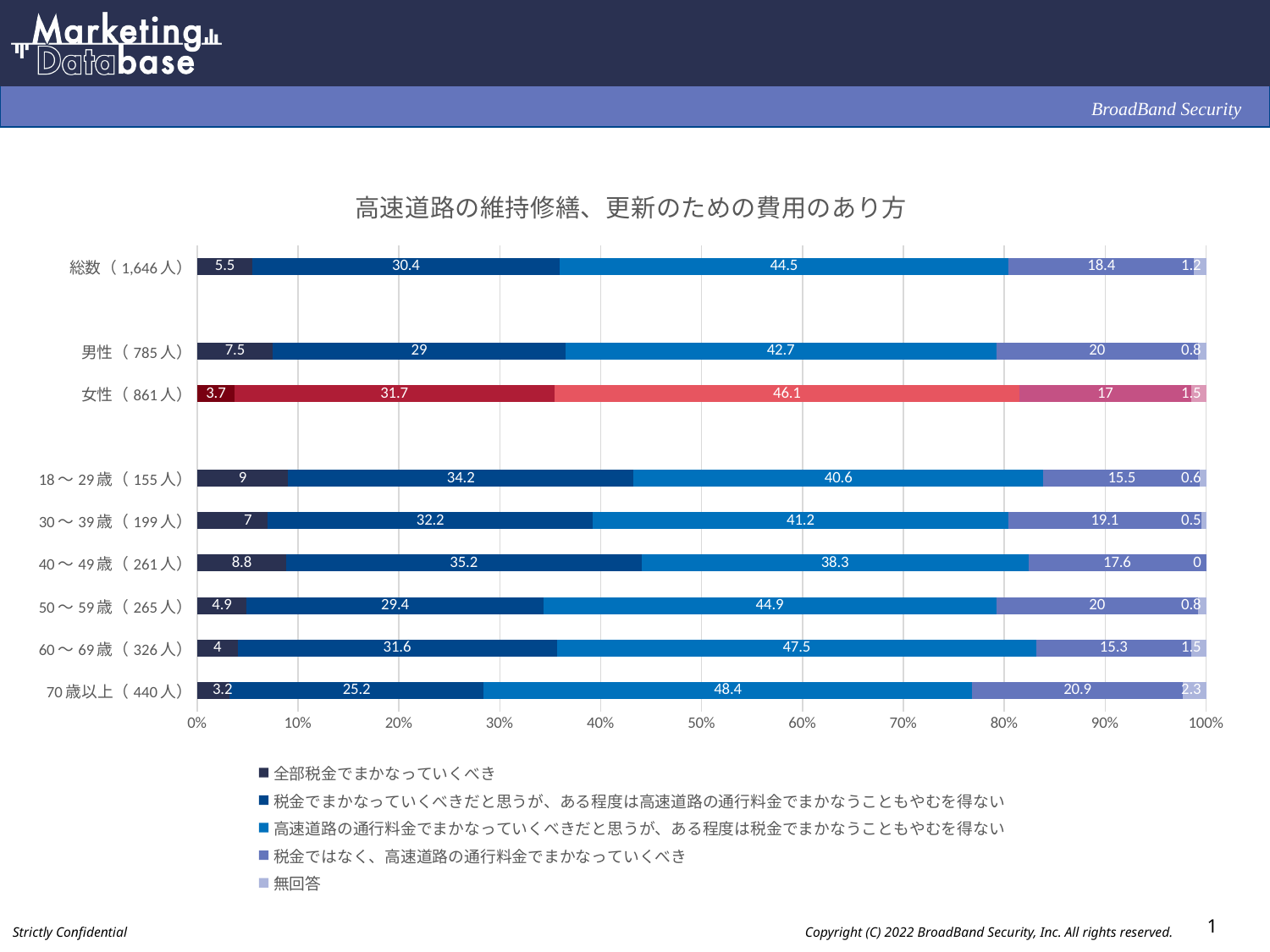
How many series does the legend list? 5 What is the value of 無回答 for 40～49歳 (261人)? 0 Which category has the highest value for 全部税金でまかなっていくべき? 18～29歳 (155人) What is the title of the chart? 高速道路の維持修繕、更新のための費用のあり方 What is the value of 税金ではなく、高速道路の通行料金でまかなっていくべき for 50～59歳 (265人)? 20 What is the value of 全部税金でまかなっていくべき for 総数 (1,646人)? 5.5 What is the difference between the 男性 (785人) and 女性 (861人) values for 全部税金でまかなっていくべき? 3.8 Which category has the lowest value for 税金でまかなっていくべきだと思うが、ある程度は高速道路の通行料金でまかなうこともやむを得ない? 70歳以上 (440人) Which is larger: the 税金ではなく、高速道路の通行料金でまかなっていくべき value for 30～39歳 (199人) or for 60～69歳 (326人)? 30～39歳 (199人) How many categories (rows) are plotted in the chart? 9 What type of chart is shown on the slide? Stacked bar chart What is the value of 高速道路の通行料金でまかなっていくべきだと思うが、ある程度は税金でまかなうこともやむを得ない for 70歳以上 (440人)? 48.4